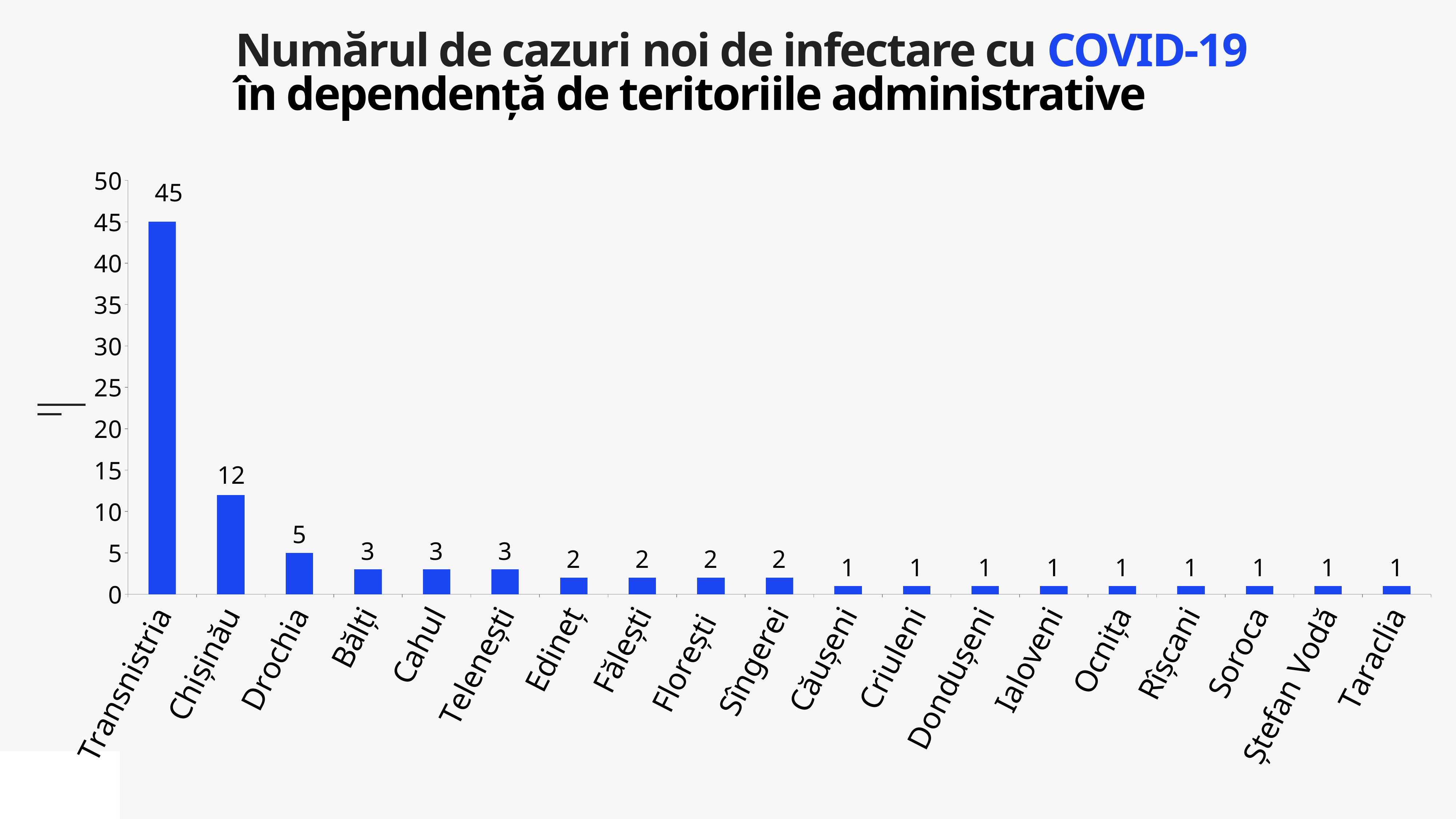
Is the value for Transnistria greater or less than 40? greater What is the difference between the values for Chișinău and Drochia? 7 What is the difference between the values for Transnistria and Chișinău? 33 Do the values rise or fall from left to right along the x axis? fall What is the value for Transnistria? 45 How many categories are shown on the x axis? 19 Which category has the highest value? Transnistria What kind of chart is shown on the slide? bar chart What is the value for Drochia? 5 What is the value for Edineț? 2 Which is larger, the value for Bălți or the value for Florești? Bălți What is the value for Chișinău? 12